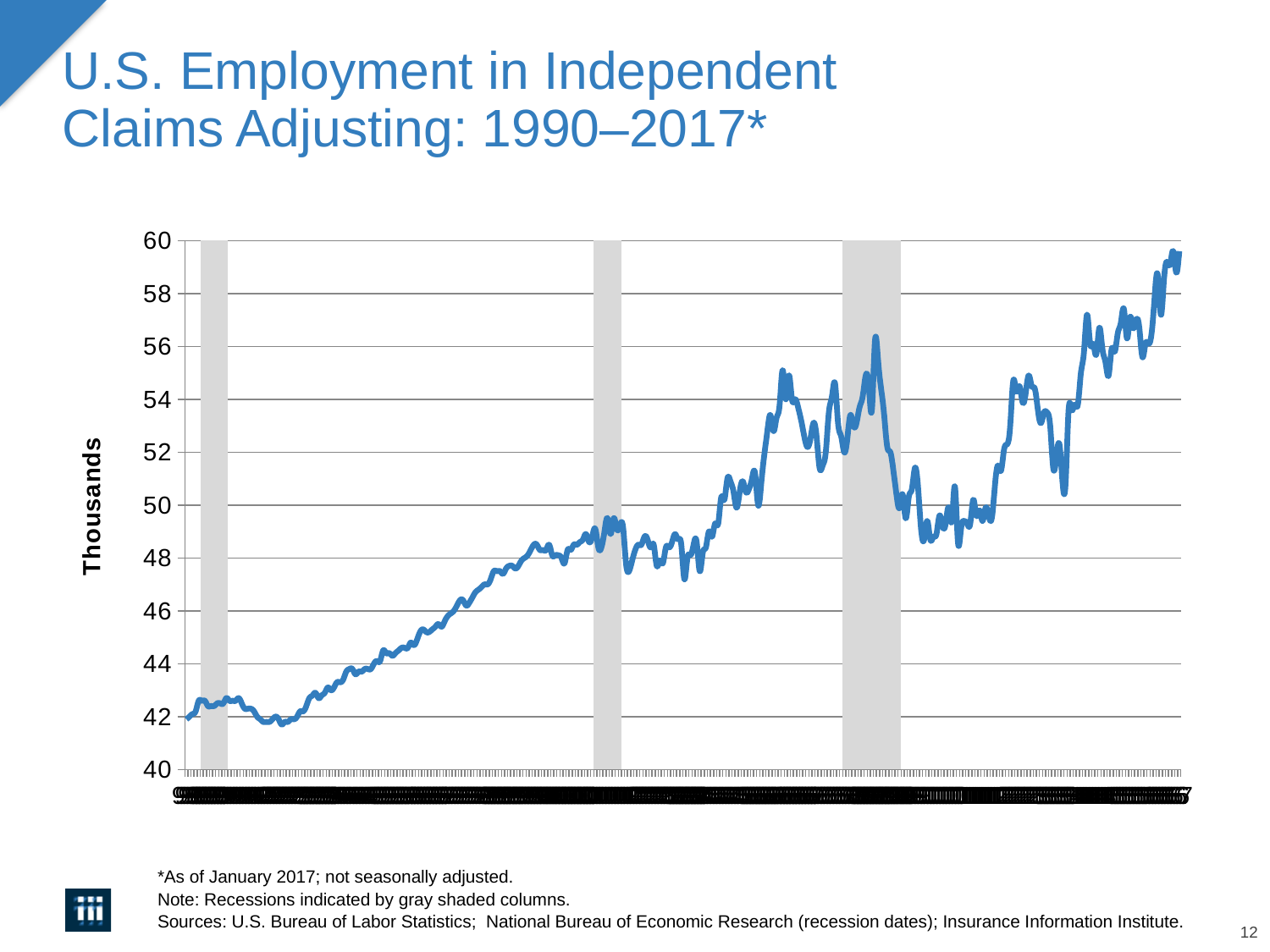
Is the value at the start of the series (left end of the line) greater or less than 40? greater Is the value at the end of the series (right end of the line) greater or less than 60? less What is the highest value shown on the vertical axis of the chart? 60 Which is larger, the value at the left end of the line or the value at the right end of the line? the right end How many gray shaded recession columns are shown on the chart? 3 Overall, do the values rise or fall from the left to the right of the chart? rise Is the value at the start of the series (left end of the line) greater or less than 44? less What is the label on the vertical axis of the chart? Thousands What is the title of the chart on the slide? U.S. Employment in Independent Claims Adjusting: 1990–2017* What kind of chart is shown on the slide? line chart